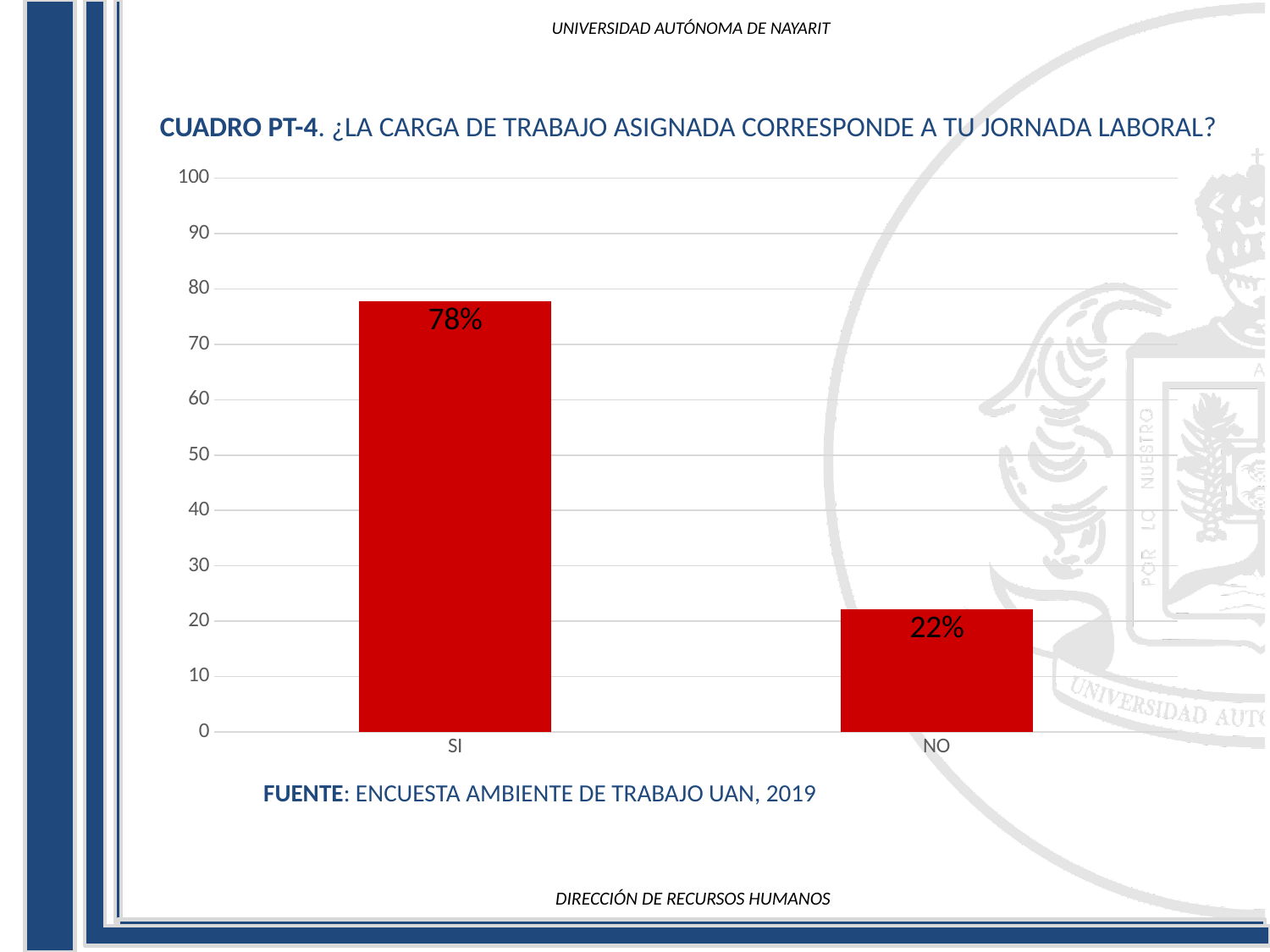
What is the difference between the values for SI and NO? 56% Which category has the lowest value? NO Is the value for NO greater or less than 30? less What is the value for SI? 78% What is the maximum value shown on the vertical axis? 100 What is the value for NO? 22% How many categories are shown on the x axis? 2 Which is larger, the value for SI or the value for NO? SI Which category has the highest value? SI What kind of chart is shown on the slide? bar chart What colour are the bars in the chart? red Is the value for SI greater or less than 70? greater